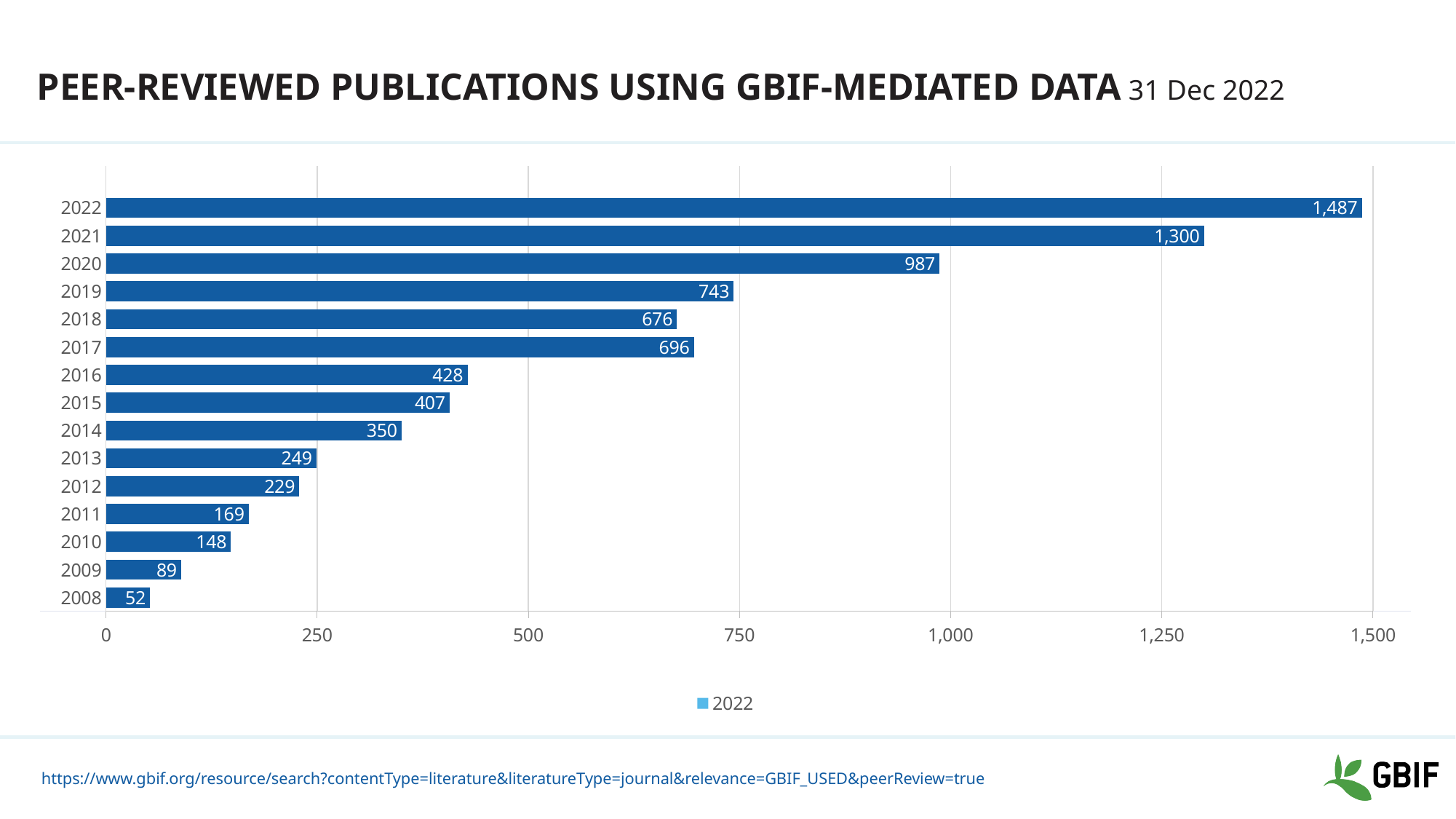
How many peer-reviewed publications are shown for 2020? 987 What is the difference between the values for 2022 and 2021? 187 How many years are shown in the chart? 15 Is the value for 2019 greater or less than 750? less Which is larger, the value for 2017 or the value for 2018? 2017 Which year has the lowest number of publications? 2008 Which year has the highest number of publications? 2022 What is the difference between the values for 2017 and 2018? 20 How many series does the legend list? 1 What is the title of the chart? PEER-REVIEWED PUBLICATIONS USING GBIF-MEDIATED DATA What kind of chart is shown on the slide? bar chart What is the value for 2014? 350